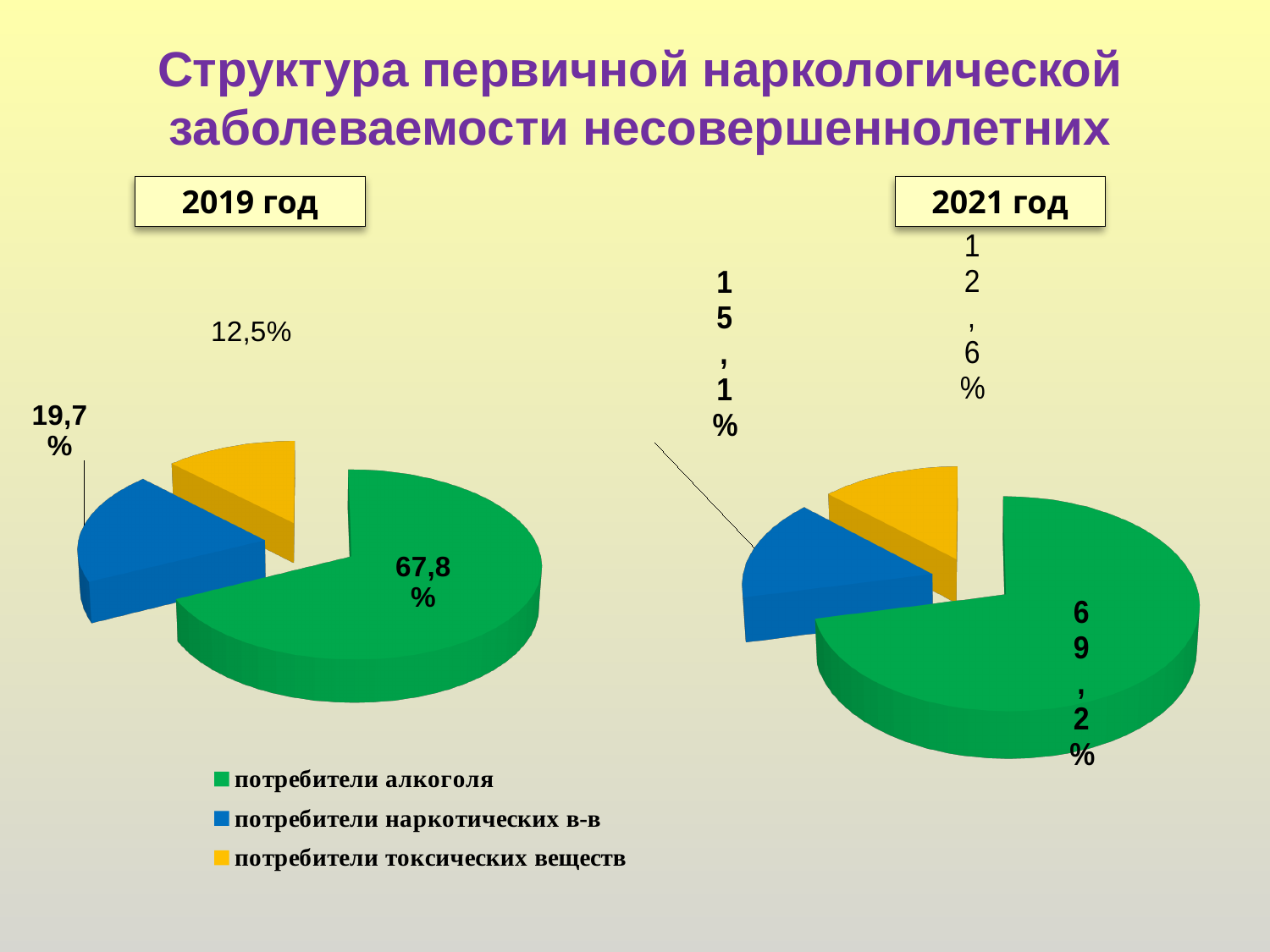
How many categories does the legend list? 3 On the 2021 год chart, what is the share for потребители токсических веществ? 12,6% What is the difference between the share of потребители алкоголя in 2021 год and in 2019 год? 1,4% On the 2021 год chart, which category has the smallest slice? потребители токсических веществ On the 2021 год chart, what is the share for потребители наркотических в-в? 15,1% On the 2019 год chart, what is the share for потребители алкоголя? 67,8% On the 2019 год chart, what is the share for потребители наркотических в-в? 19,7% On the 2021 год chart, what is the share for потребители алкоголя? 69,2% On the 2019 год chart, which category has the largest slice? потребители алкоголя On the 2019 год chart, what is the share for потребители токсических веществ? 12,5% Which is larger: the share of потребители наркотических в-в in 2019 год or in 2021 год? 2019 год What kind of chart is used for the 2019 год data? pie chart